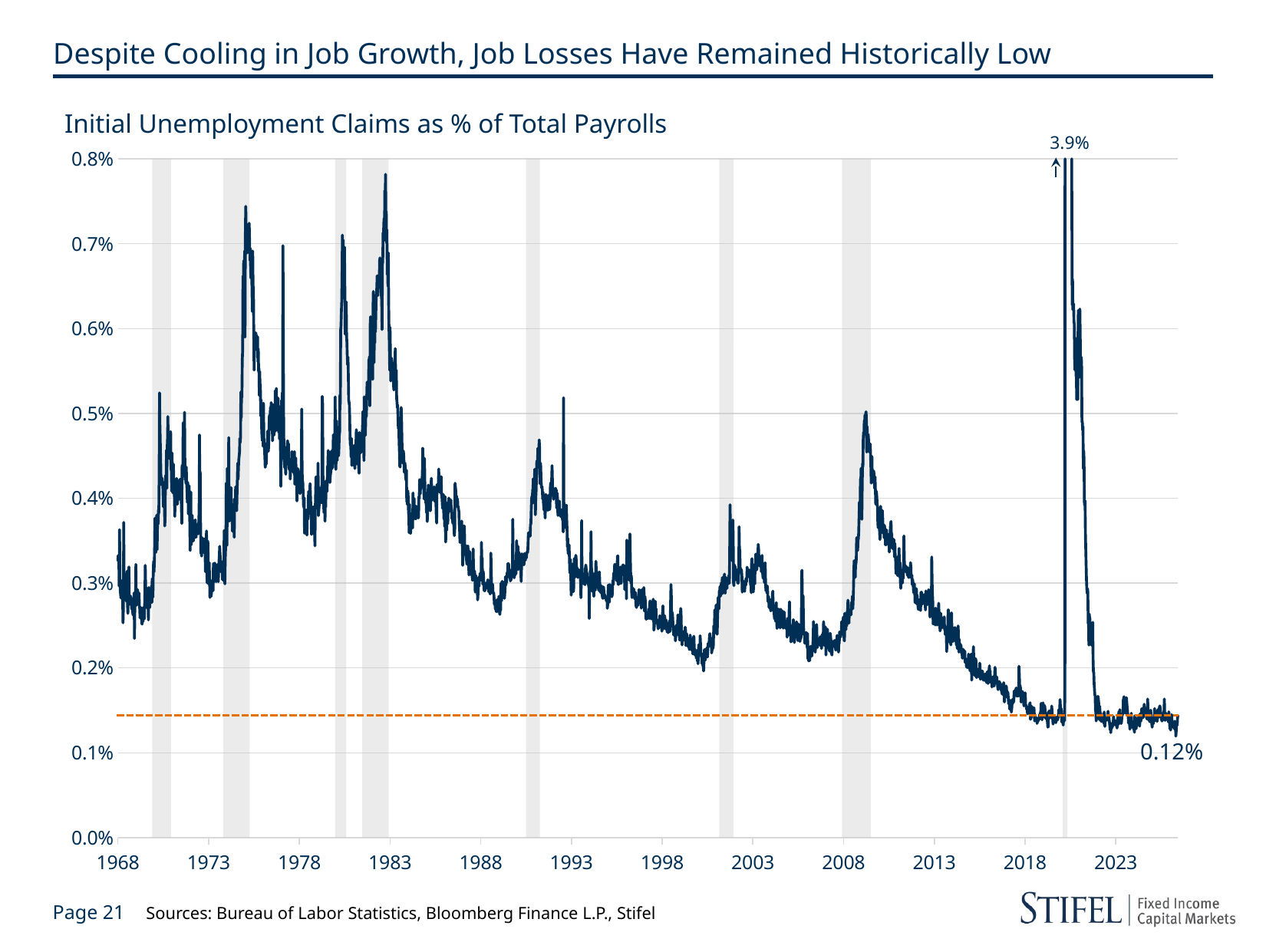
Is the value around 2000 greater or less than 0.3%? less What is the most recent value labeled at the right end of the line? 0.12% What is the title of the chart? Initial Unemployment Claims as % of Total Payrolls Between 2009 and 2019, does the line generally rise or fall? fall What is the highest value labeled on the chart? 3.9% What kind of chart is shown on the slide? line chart Is the peak value around 1983 greater or less than 0.7%? greater What is the difference between the labeled 2020 spike and the latest labeled value? 3.78% What is the first year shown on the x axis? 1968 Which peak is higher, the one around 1983 or the one around 2009? around 1983 What is the value of the labeled spike around 2020? 3.9% Is the peak value around 2009 greater or less than 0.6%? less